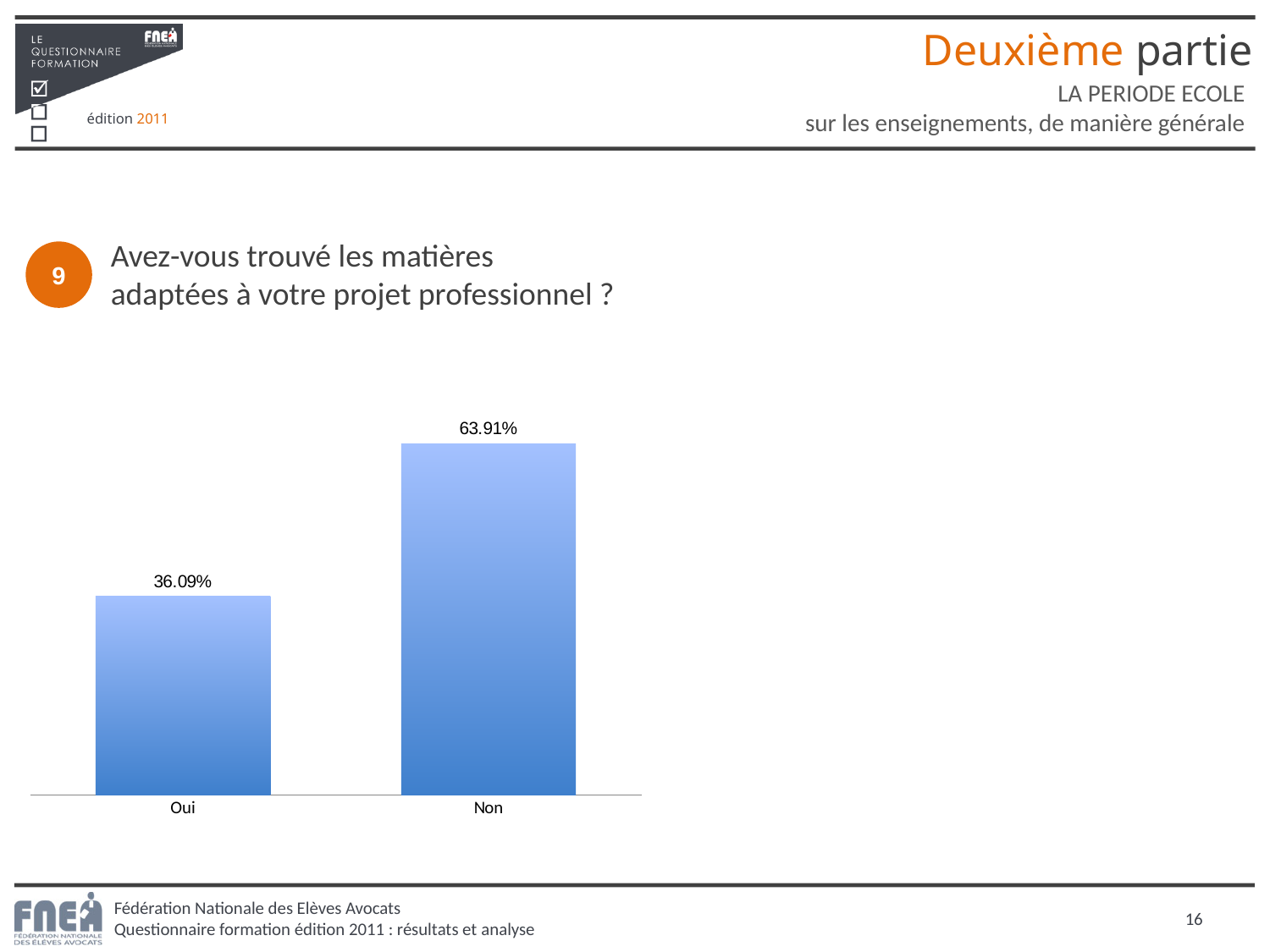
Which category has the lowest value? Oui What is the value for Non? 63.91% Which is larger, the value for Oui or the value for Non? Non Which category has the highest value? Non What question does the chart answer, according to the text next to the number 9? Avez-vous trouvé les matières adaptées à votre projet professionnel ? How many categories are shown in the chart? 2 What kind of chart is shown on the slide? Bar chart What colour are the bars in the chart? Blue What is the total of the two values shown in the chart? 100% What is the difference between the values for Non and Oui? 27.82% What is the value for Oui? 36.09%